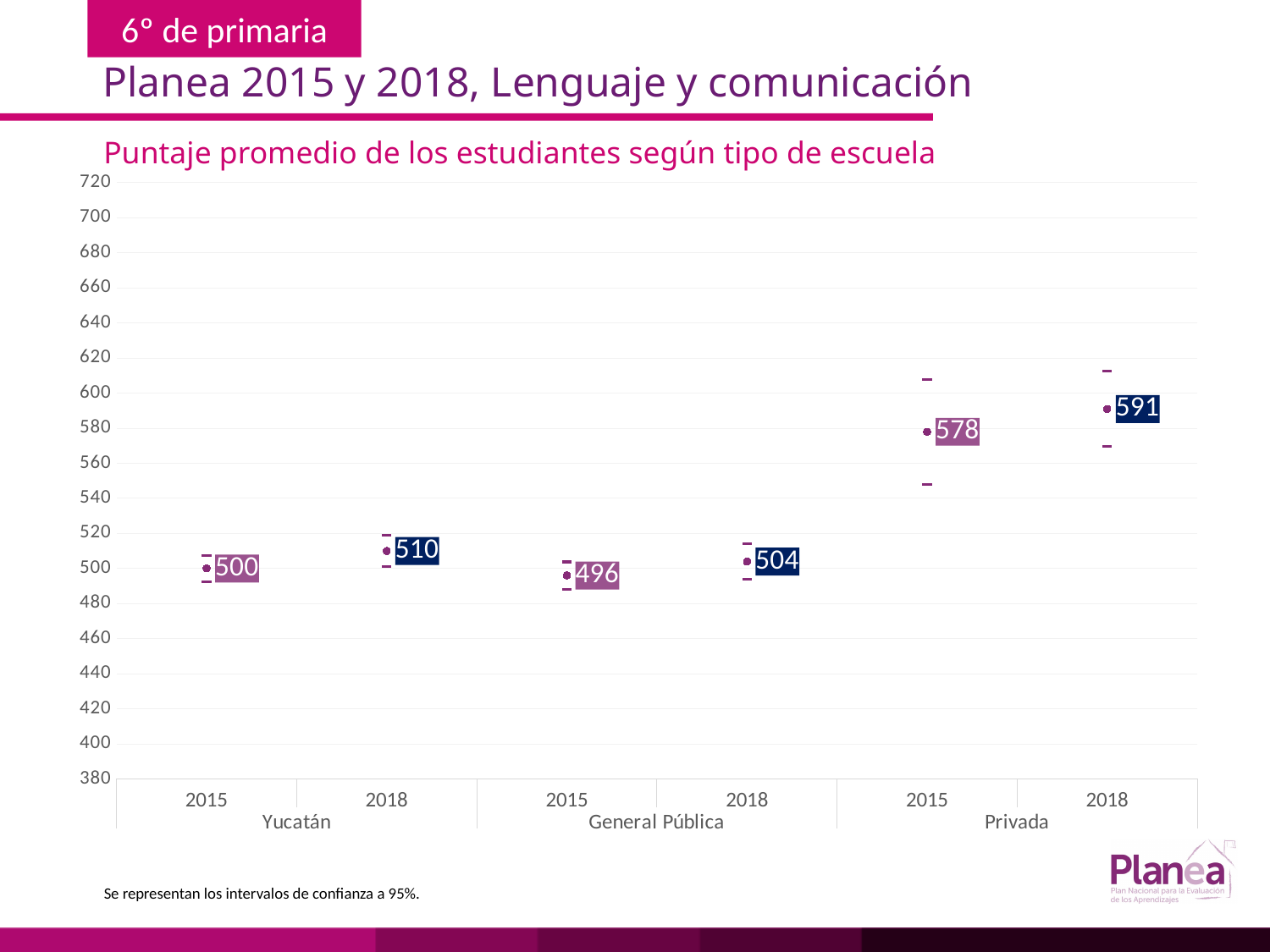
Which school type and year has the lowest average score? General Pública 2015 By how many points did the Privada average score change from 2015 to 2018? 13 What is the average score for Yucatán in 2015? 500 Did the average score for Yucatán rise or fall from 2015 to 2018? rise Which school type and year has the highest average score? Privada 2018 What is the difference between the Yucatán 2018 score and the General Pública 2018 score? 6 What is the average score for Privada in 2018? 591 What is the title of the chart? Puntaje promedio de los estudiantes según tipo de escuela What is the average score for General Pública in 2015? 496 Is the Privada 2015 score greater or less than 560? greater Which is larger, the Yucatán 2015 score or the General Pública 2015 score? Yucatán 2015 How many data points are plotted on the chart? 6